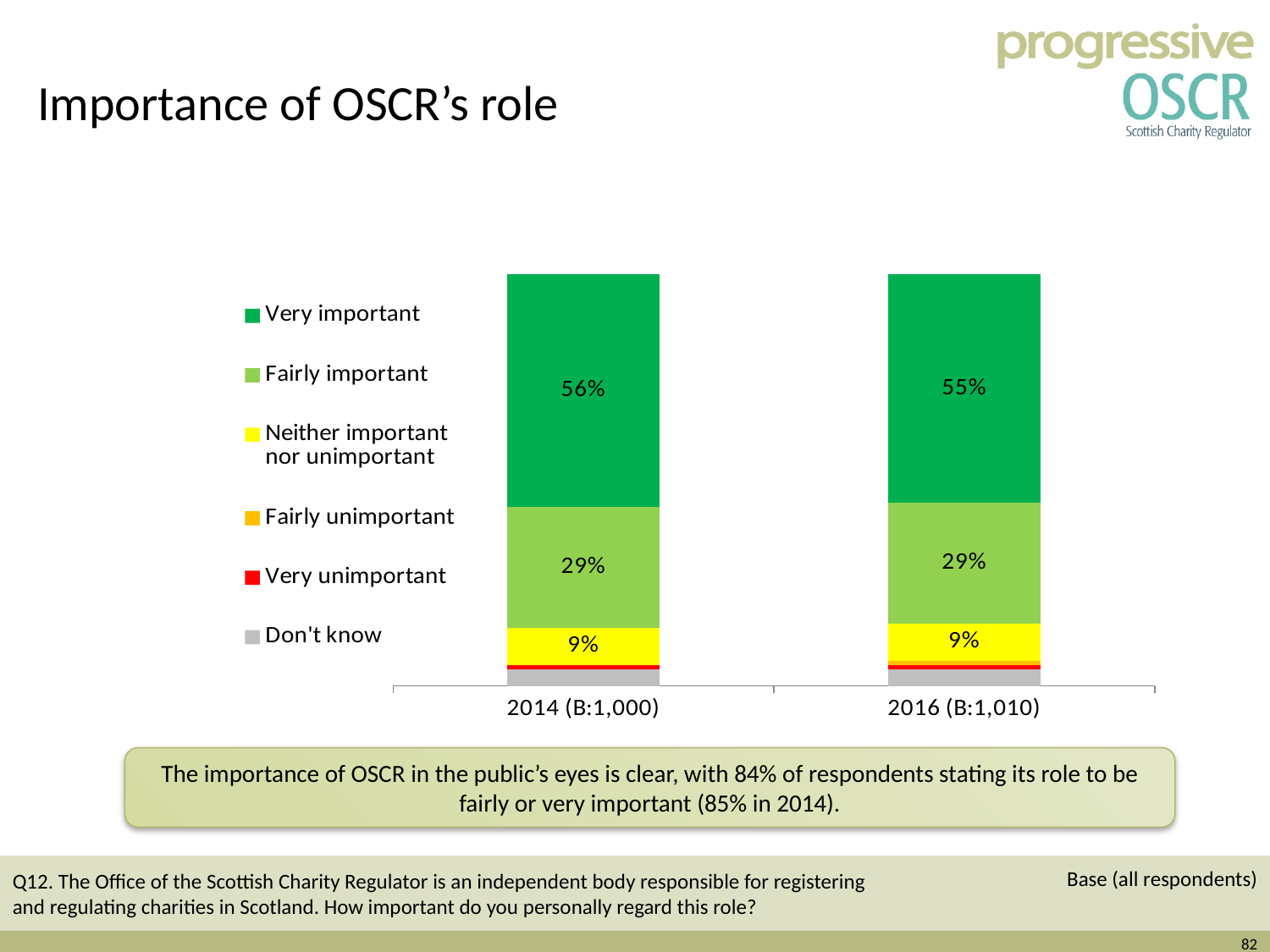
What kind of chart is shown on the slide? Stacked bar chart Which response option is the largest segment in both bars? Very important How many series does the legend list? 6 What is the difference between the 'Very important' share in 2014 and in 2016? 1% What percentage of respondents rated OSCR's role as 'Fairly important' in 2016 (B:1,010)? 29% What percentage of respondents chose 'Neither important nor unimportant' in 2014 (B:1,000)? 9% What percentage of respondents rated OSCR's role as 'Very important' in 2014 (B:1,000)? 56% What is the difference between the 'Very important' and 'Fairly important' shares in 2014 (B:1,000)? 27% Which year had the higher 'Very important' share, 2014 or 2016? 2014 Which legend entry is shown in red? Very unimportant How many categories are shown on the x axis? 2 What percentage of respondents rated OSCR's role as 'Very important' in 2016 (B:1,010)? 55%